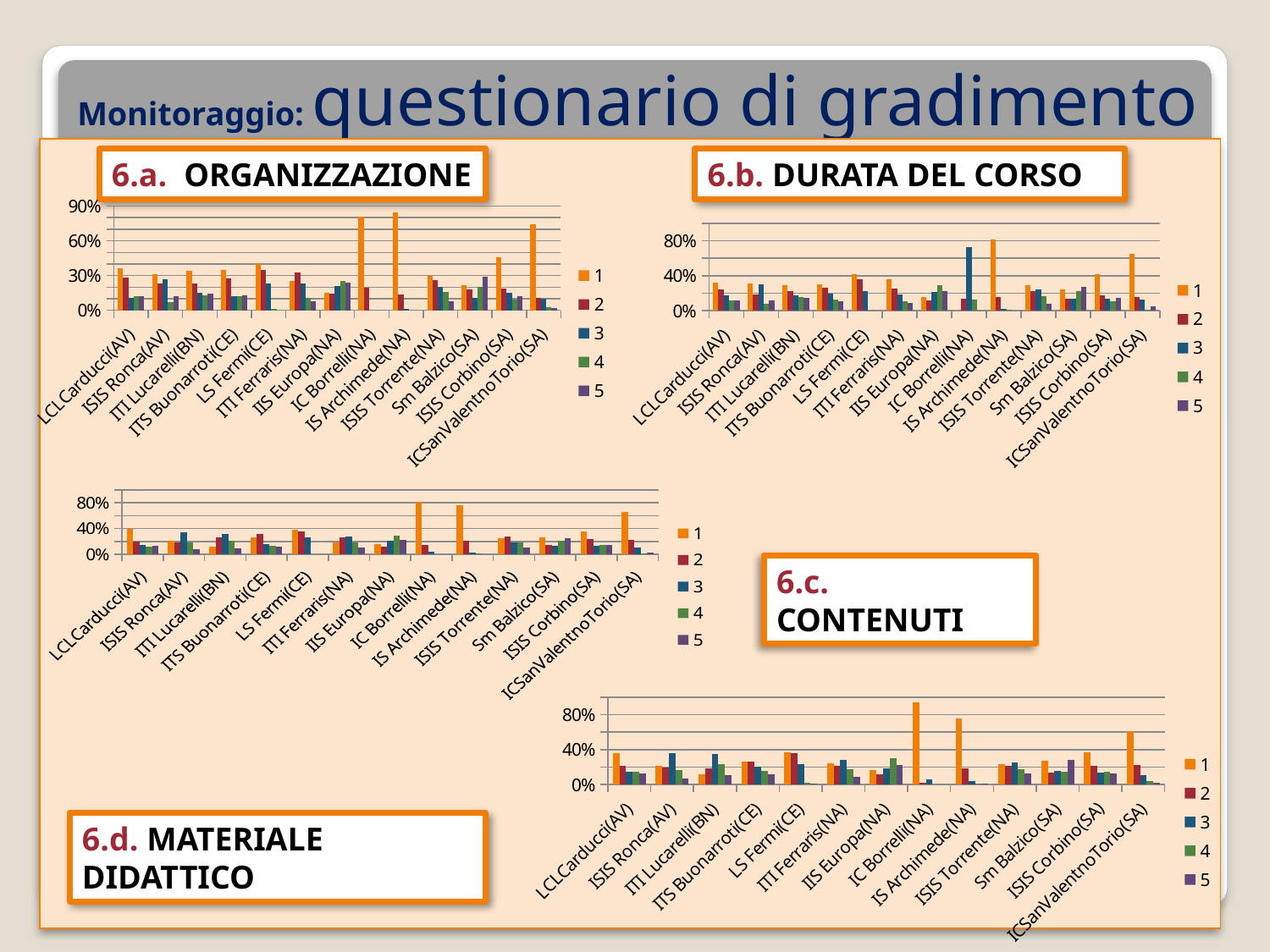
In the top-right chart (6.b. DURATA DEL CORSO), is the value of series 1 for IS Archimede(NA) greater or less than 40%? greater In the bottom-right chart, is the value of series 1 for IC Borrelli(NA) greater or less than 80%? greater In the top-right chart (6.b. DURATA DEL CORSO), is the value of series 3 for IC Borrelli(NA) greater or less than 40%? greater What kind of chart is the top-left chart titled 6.a. ORGANIZZAZIONE? bar chart What colour represents series 1 in the top-right chart (6.b. DURATA DEL CORSO)? orange How many school categories are shown on the x axis of the top-left chart (6.a. ORGANIZZAZIONE)? 13 What are the legend entries of the top-left chart (6.a. ORGANIZZAZIONE)? 1, 2, 3, 4, 5 In the bottom-right chart, which is larger for IC Borrelli(NA): series 1 or series 3? series 1 How many series does the legend of the top-right chart (6.b. DURATA DEL CORSO) list? 5 In the top-right chart (6.b. DURATA DEL CORSO), which category has the tallest bar for series 1? IS Archimede(NA)